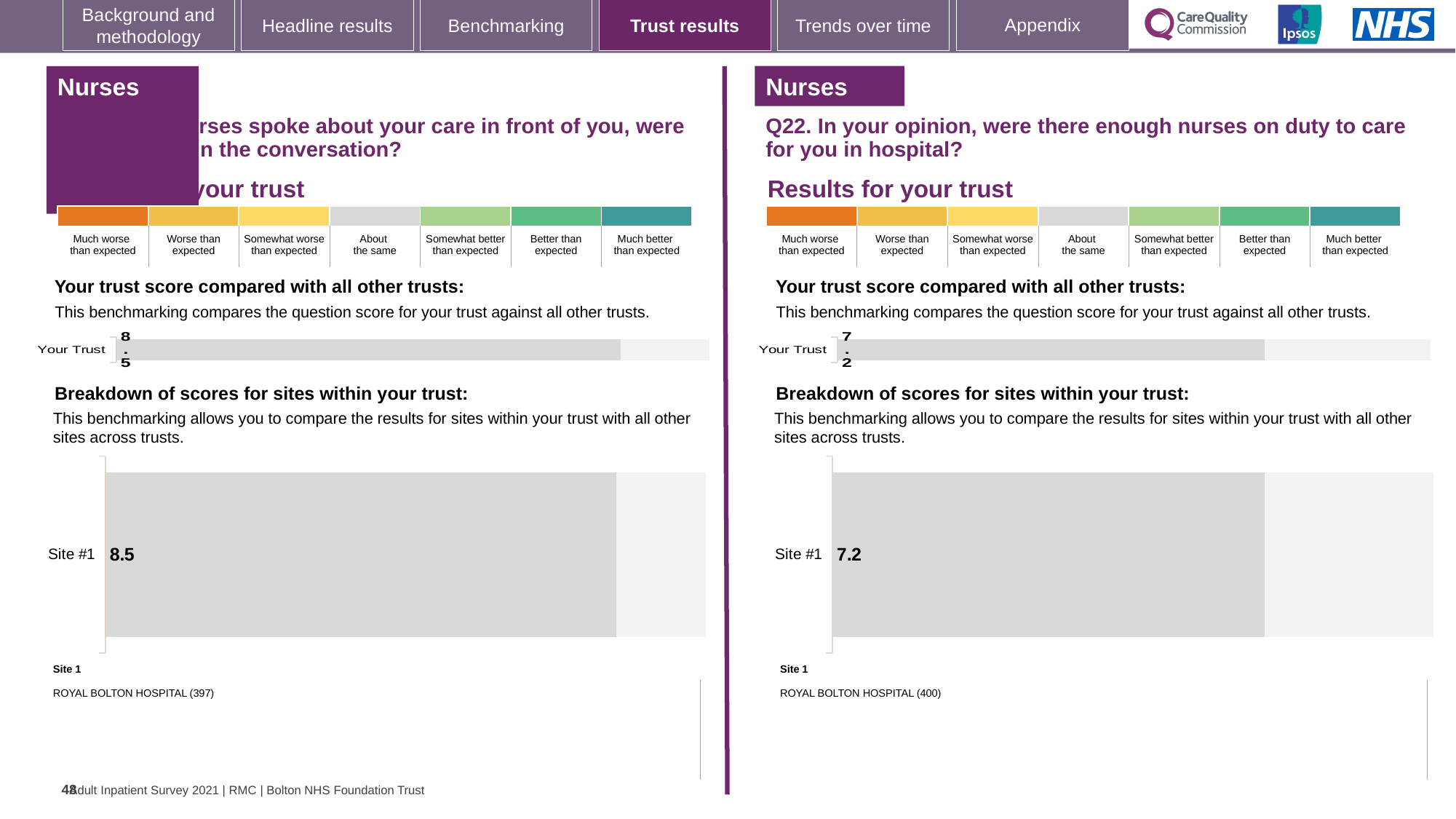
On the right-hand panel (Q22), what is the score shown for Your Trust? 7.2 What is the difference between the Your Trust score on the left-hand panel and the Your Trust score on the right-hand panel (Q22)? 1.3 On the left-hand panel, what is the score shown for Your Trust? 8.5 On the left-hand panel, which hospital is listed as Site 1? ROYAL BOLTON HOSPITAL (397) Which is larger: the Site #1 score on the left-hand panel or the Site #1 score on the right-hand panel (Q22)? Left-hand panel (8.5) How many sites are shown in the site breakdown chart on the right-hand panel (Q22)? 1 On the left-hand panel, what is the score shown for Site #1? 8.5 What is the difference between the Site #1 score on the left-hand panel and the Site #1 score on the right-hand panel (Q22)? 1.3 On the right-hand panel (Q22), what is the score shown for Site #1? 7.2 What type of chart is used to show the Site #1 score on the right-hand panel (Q22)? Bar chart On the right-hand panel (Q22), which hospital is listed as Site 1? ROYAL BOLTON HOSPITAL (400) How many sites are shown in the site breakdown chart on the left-hand panel? 1